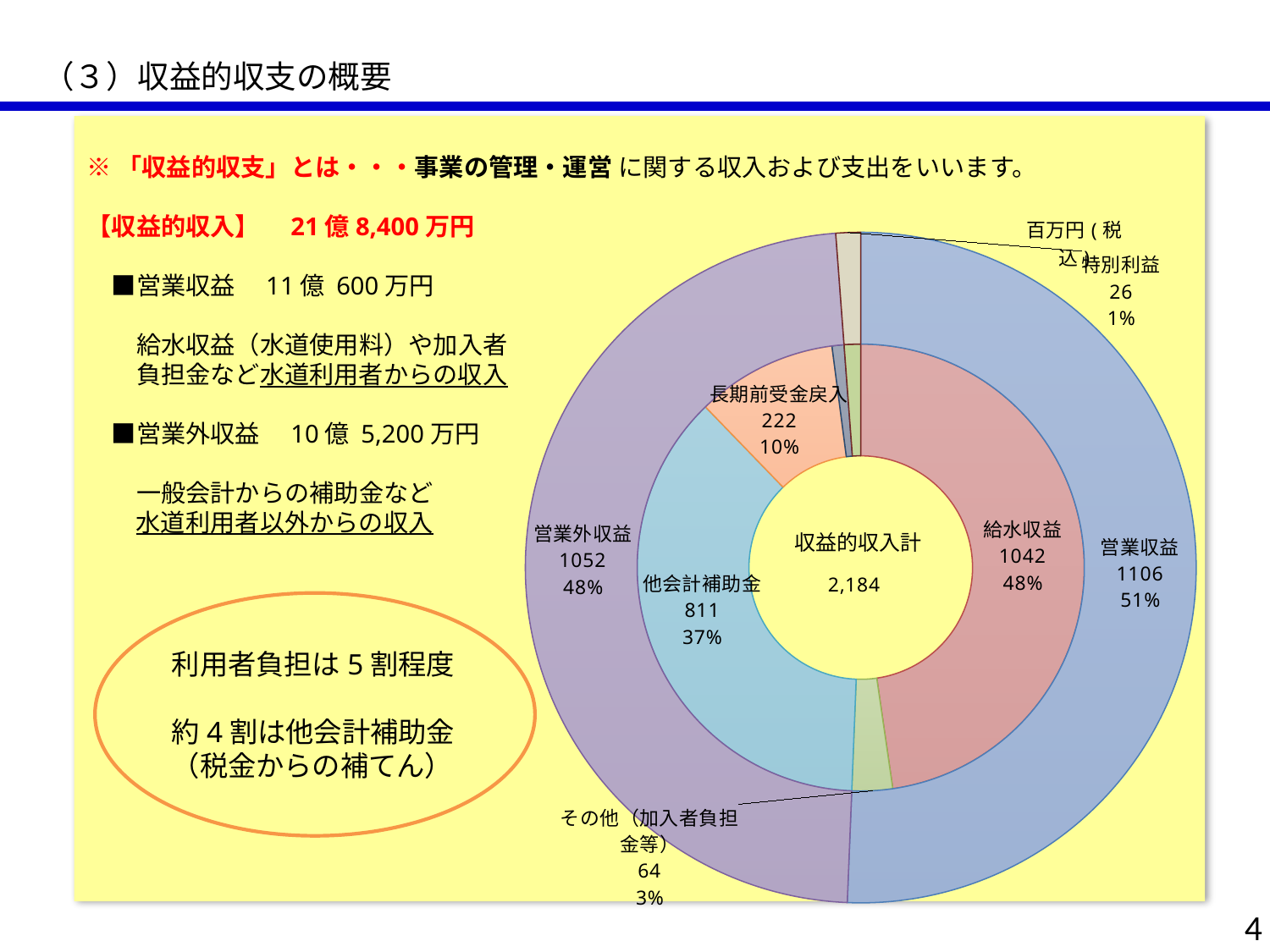
What is the value for 営業収益 in the outer ring? 1106 What is the value for 長期前受金戻入? 222 What is the total shown in the centre of the chart (収益的収入計)? 2,184 What is the value for 他会計補助金 in the inner ring? 811 What percentage share does その他（加入者負担金等） have? 3% What percentage share does 営業外収益 have in the outer ring? 48% What percentage share does 給水収益 have? 48% What is the difference between 営業収益 (1106) and 営業外収益 (1052)? 54 Which category in the outer ring has the smallest value? 特別利益 What is the value for 特別利益? 26 Which is larger, 給水収益 or 他会計補助金? 給水収益 What type of chart is shown on the slide? Doughnut chart